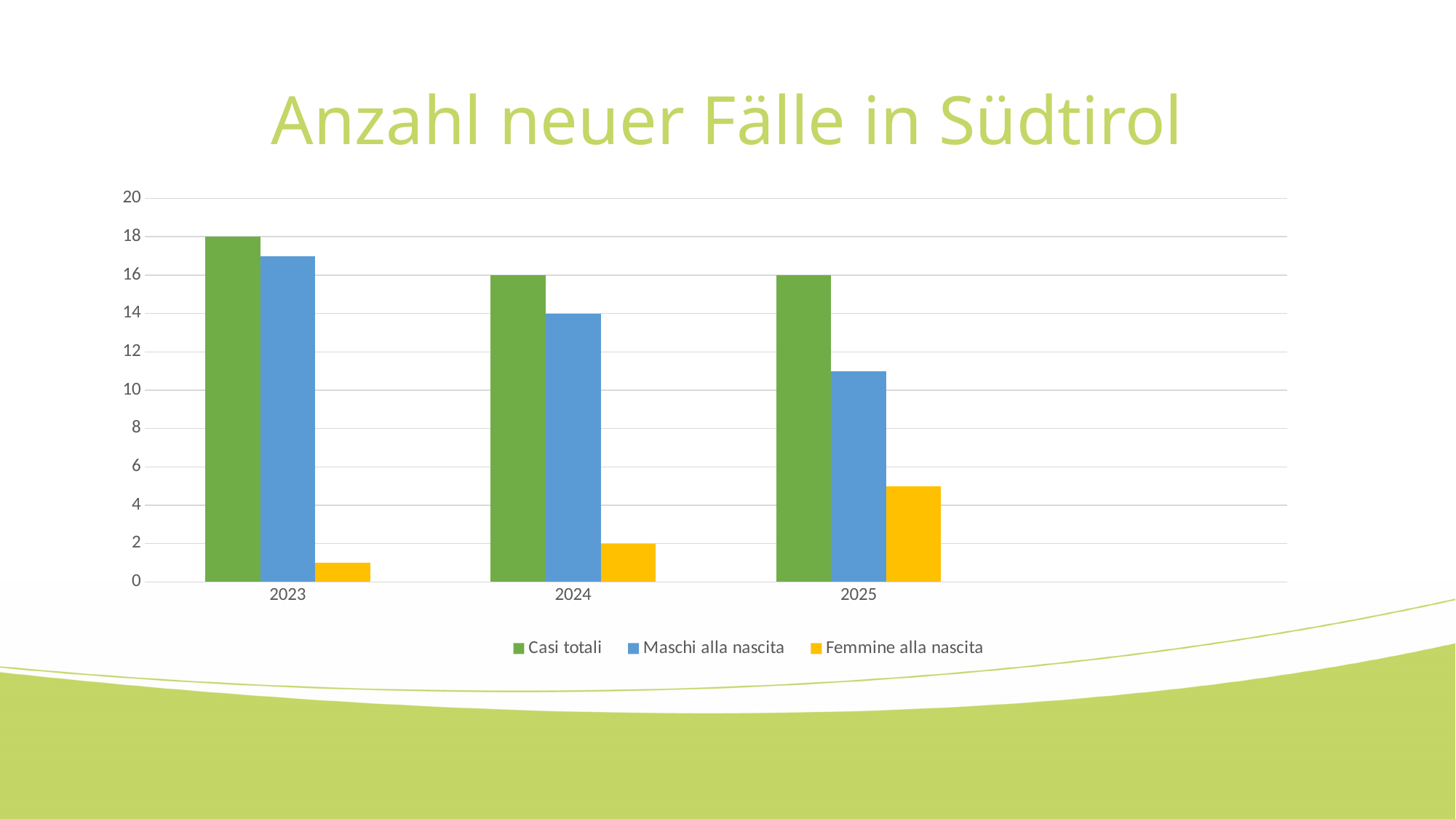
How many years are shown on the x axis? 3 How many series does the legend list? 3 Do the values for Maschi alla nascita rise or fall from 2023 to 2025? fall What is the value of Maschi alla nascita for 2024? 14 In which year is Femmine alla nascita highest? 2025 What is the difference between Casi totali in 2023 and Casi totali in 2024? 2 What is the value of Femmine alla nascita for 2024? 2 Is the value for Maschi alla nascita in 2025 greater or less than 12? less What is the value of Casi totali for 2023? 18 What is the value of Casi totali for 2024? 16 What type of chart is shown on the slide? bar chart Is the value for Femmine alla nascita in 2025 greater or less than 4? greater